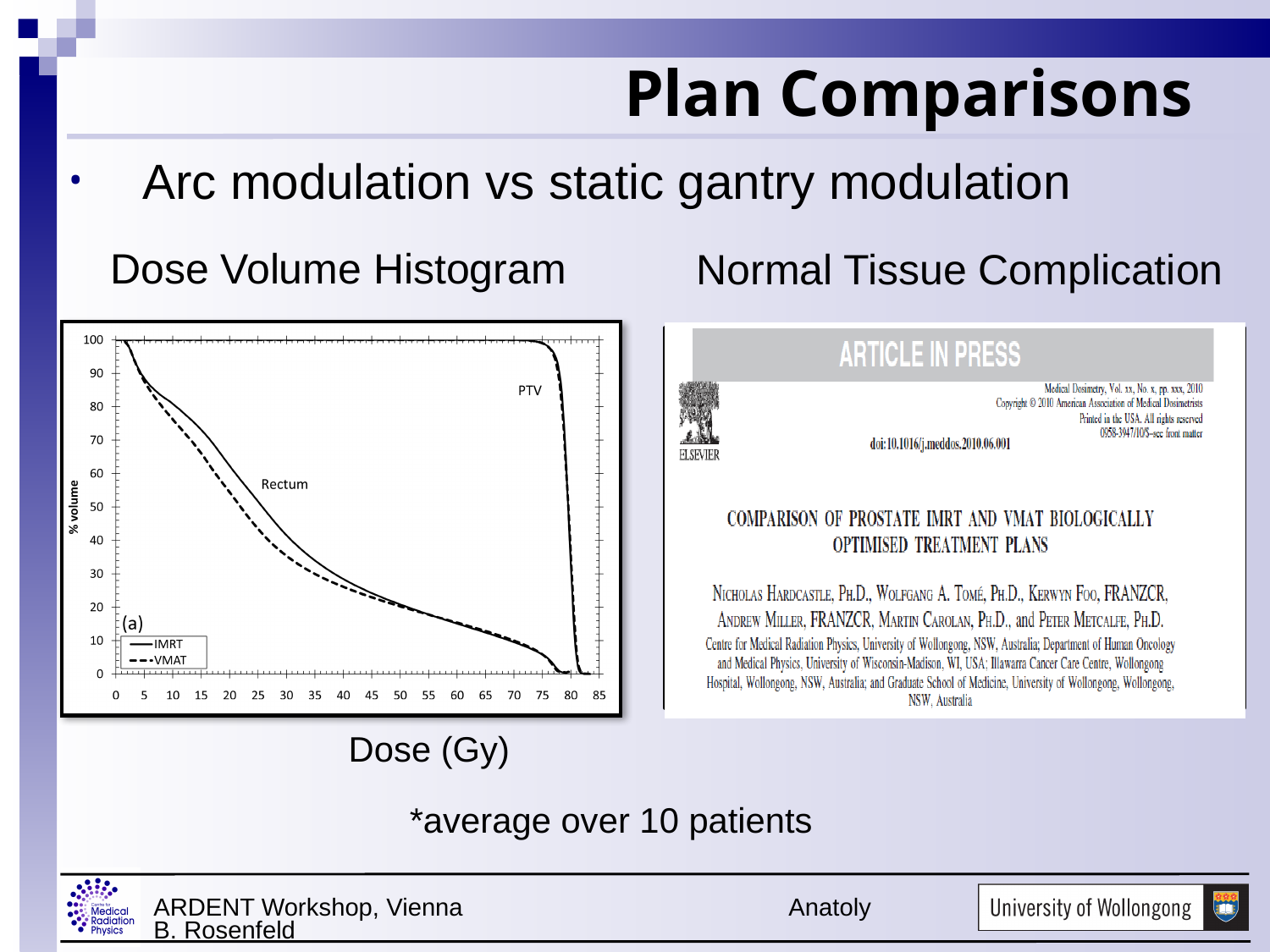
Which two series are listed in the legend of the Dose Volume Histogram? IMRT and VMAT How many structures (labelled curves) are shown in the Dose Volume Histogram? 2 (PTV and Rectum) In the Dose Volume Histogram, is the PTV % volume at 80 Gy greater or less than 20? less How many series does the legend of the Dose Volume Histogram list? 2 In the Dose Volume Histogram, at 20 Gy, which Rectum curve shows the higher % volume, IMRT or VMAT? IMRT In the Dose Volume Histogram, does the Rectum % volume rise or fall as dose increases? Fall What is the label of the y axis of the Dose Volume Histogram? % volume In the Dose Volume Histogram, which structure has the higher % volume at 60 Gy, PTV or Rectum? PTV In the Dose Volume Histogram, is the Rectum IMRT % volume at 10 Gy greater or less than 70? greater In the Dose Volume Histogram, is the Rectum VMAT % volume at 30 Gy greater or less than 40? less What kind of chart is the Dose Volume Histogram on the slide? Line chart